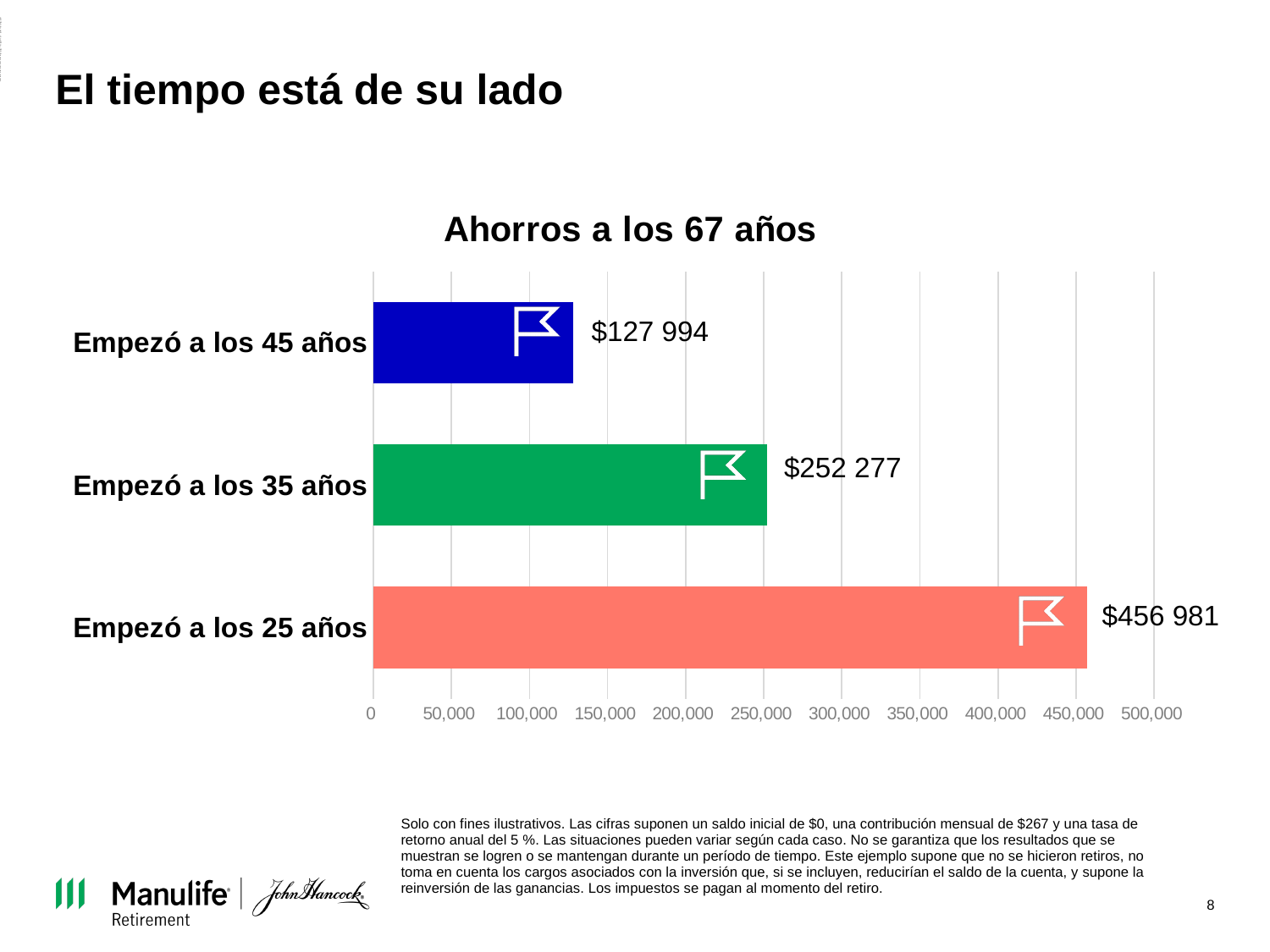
What is the value shown for 'Empezó a los 45 años'? $127 994 Is the value for 'Empezó a los 25 años' greater or less than 400,000? greater What is the difference between the values for 'Empezó a los 25 años' and 'Empezó a los 45 años'? $328 987 Which category has the highest savings value? Empezó a los 25 años What is the value shown for 'Empezó a los 25 años'? $456 981 What is the value shown for 'Empezó a los 35 años'? $252 277 What is the title of the chart? Ahorros a los 67 años What is the difference between the values for 'Empezó a los 35 años' and 'Empezó a los 45 años'? $124 283 Which category has the lowest savings value? Empezó a los 45 años What kind of chart is shown on the slide? Bar chart How many categories are shown in the chart? 3 Which is larger, the value for 'Empezó a los 35 años' or 'Empezó a los 45 años'? Empezó a los 35 años